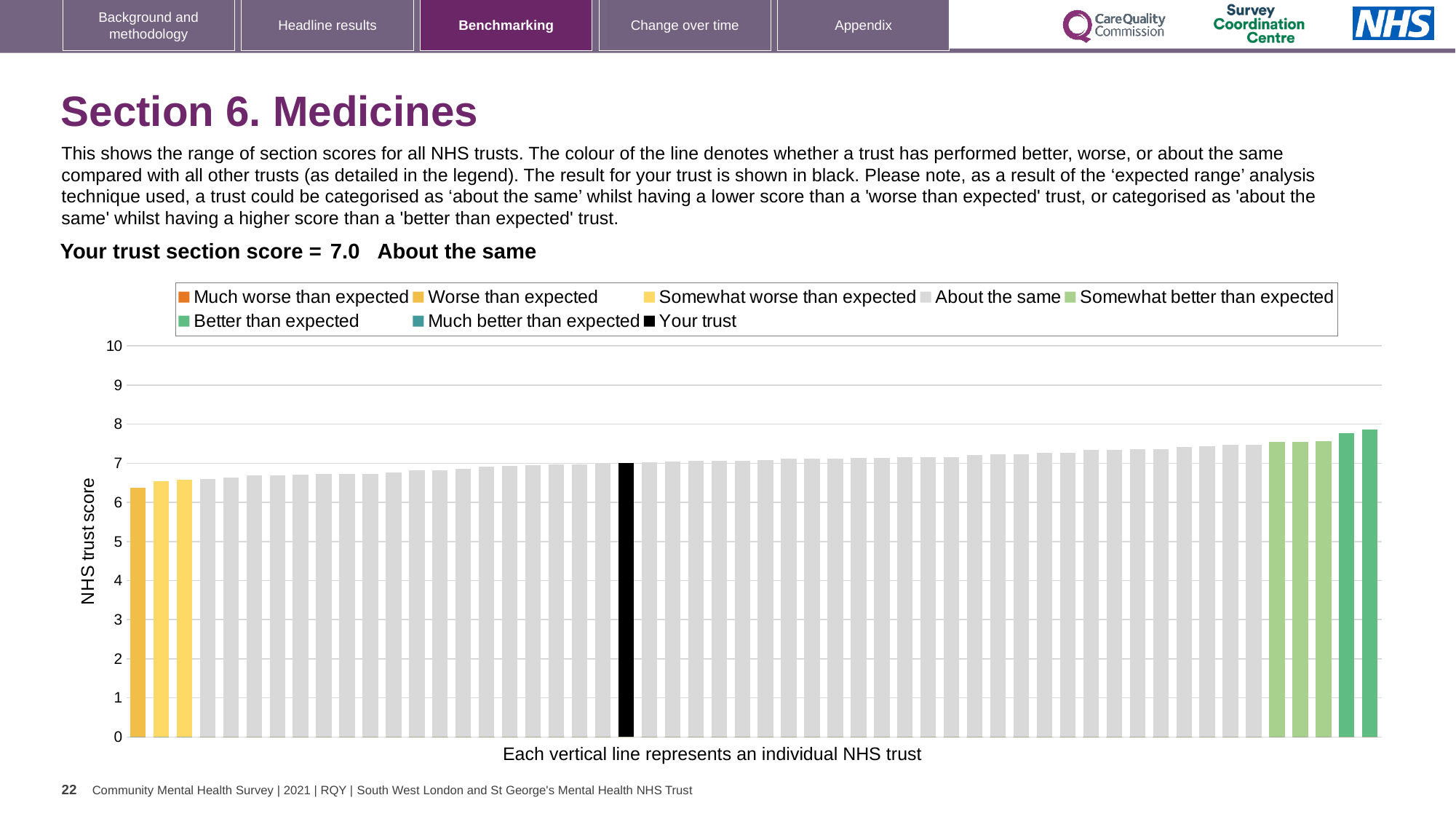
Do the bar values rise or fall from left to right along the x axis? Rise Is the value for your trust (the black bar) greater or less than 5? greater Is the value of the highest bar greater or less than 7? greater Is the value of the highest bar greater or less than 8? less How many bars are coloured as 'Worse than expected'? 1 What is the label on the vertical axis? NHS trust score How many entries does the chart legend list? 8 What is the section score for your trust? 7.0 Which performance category is your trust placed in for Section 6. Medicines? About the same What kind of chart is shown on the slide? Bar chart